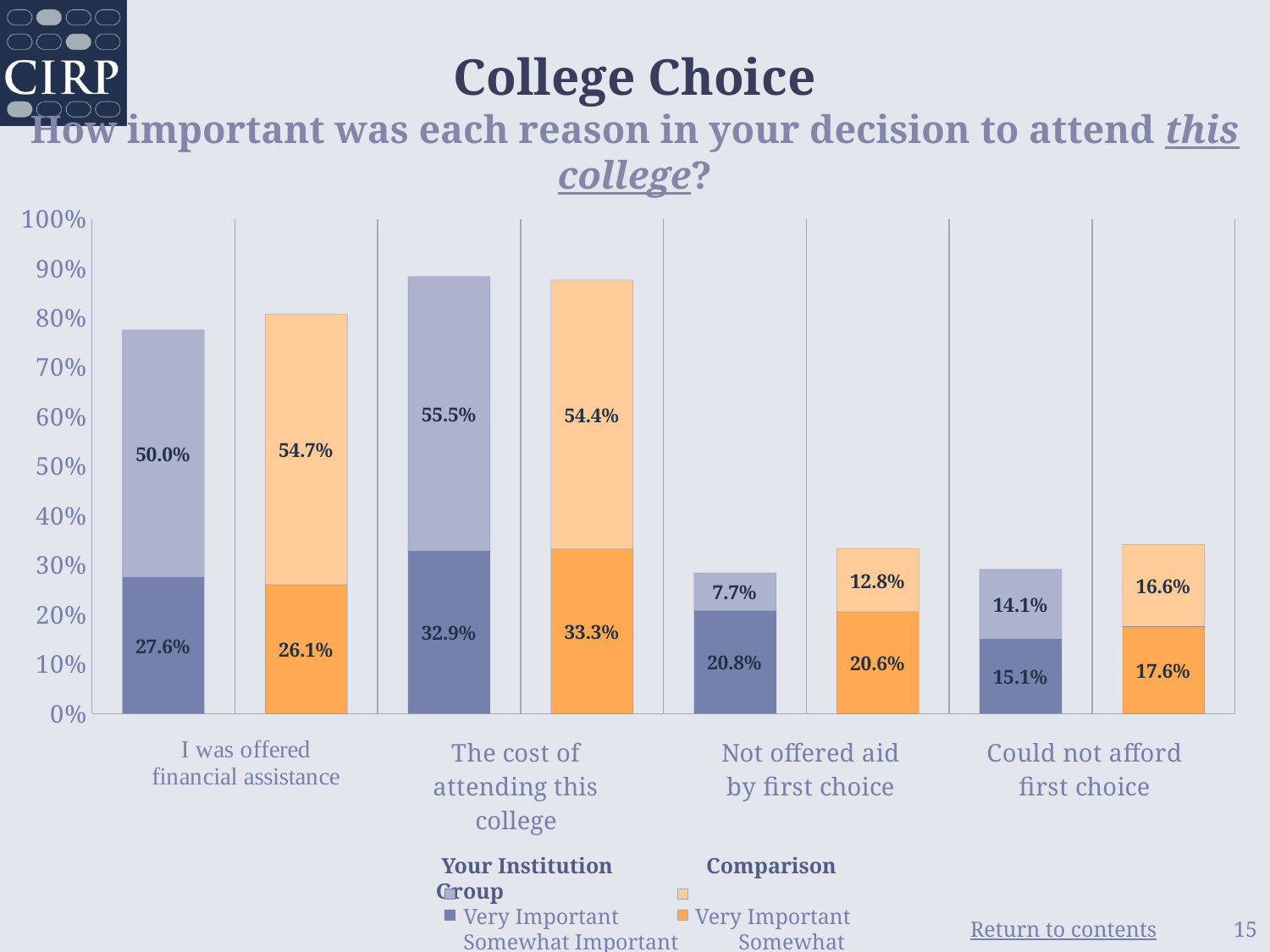
How many series does the legend list? 4 What is the total height of the Comparison Group's stacked bar for "Could not afford first choice"? 34.2% How many reasons (categories) are shown on the x axis? 4 What kind of chart is shown on the slide? Stacked bar chart What percentage of the Comparison Group rated "I was offered financial assistance" as Somewhat Important? 54.7% Which reason has the highest Very Important percentage for Your Institution? The cost of attending this college Which reason has the lowest Somewhat Important percentage for Your Institution? Not offered aid by first choice What is the Comparison Group's Very Important value for "Could not afford first choice"? 17.6% What is the difference between the Comparison Group's and Your Institution's Somewhat Important values for "Not offered aid by first choice"? 5.1% What is the total height of Your Institution's stacked bar for "The cost of attending this college"? 88.4% What percentage of Your Institution respondents rated "The cost of attending this college" as Very Important? 32.9% For "I was offered financial assistance", which is larger: Your Institution's Very Important value or the Comparison Group's Very Important value? Your Institution